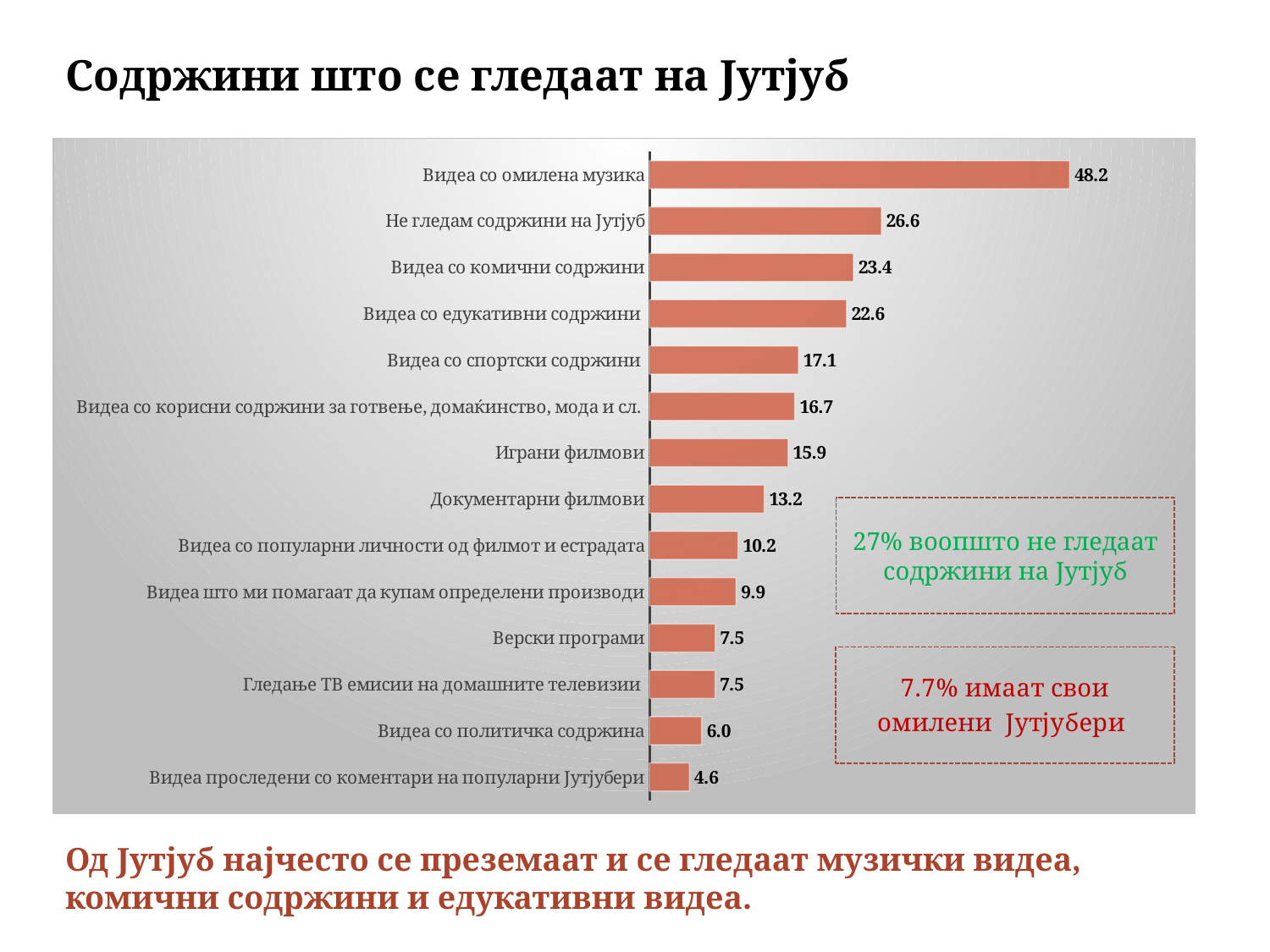
What is the value for "Документарни филмови"? 13.2 What is the value for "Видеа со омилена музика"? 48.2 Which is larger: the value for "Видеа со спортски содржини" or "Играни филмови"? Видеа со спортски содржини What is the difference between the values for "Видеа со комични содржини" and "Видеа со едукативни содржини"? 0.8 What is the difference between the values for "Видеа со омилена музика" and "Не гледам содржини на Јутјуб"? 21.6 What kind of chart is shown on the slide? Bar chart Which category has the lowest value? Видеа проследени со коментари на популарни Јутјубери How many categories are shown in the chart? 14 What is the value for "Видеа со едукативни содржини"? 22.6 Which category has the highest value? Видеа со омилена музика What is the value for "Видеа со политичка содржина"? 6.0 What is the title of the slide? Содржини што се гледаат на Јутјуб